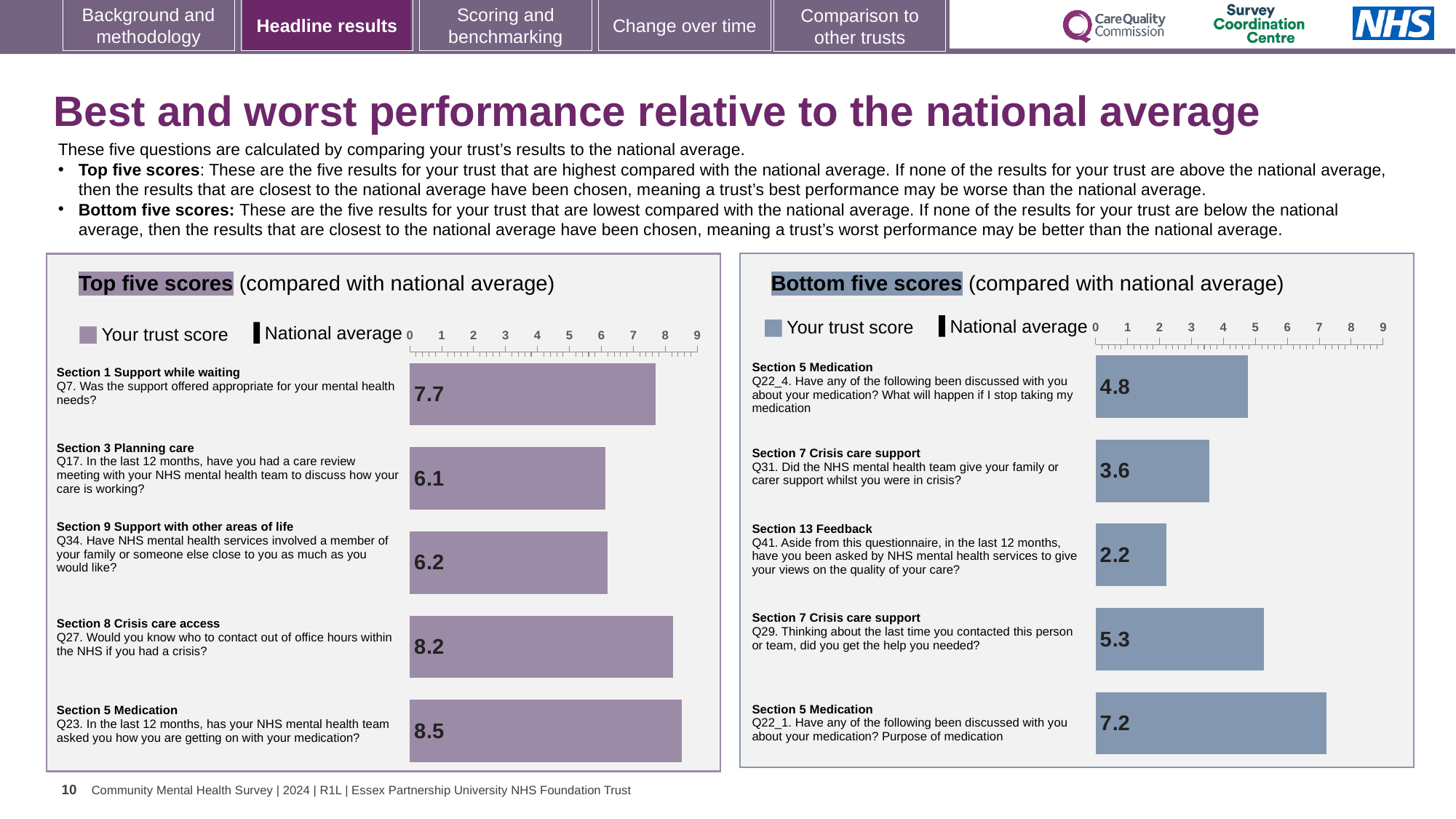
In the Bottom five scores chart, which has the larger trust score, Q22_4 or Q29? Q29 In the Top five scores chart, what is the trust score for Q27 (Would you know who to contact out of office hours within the NHS if you had a crisis?)? 8.2 In the Bottom five scores chart, which question has the highest trust score? Q22_1 In the Top five scores chart, which question has the lowest trust score? Q17 In the Bottom five scores chart, what is the trust score for Q22_1 (Purpose of medication)? 7.2 In the Top five scores chart, what is the trust score for Q17 (care review meeting in the last 12 months)? 6.1 In the Bottom five scores chart, what is the trust score for Q31 (Did the NHS mental health team give your family or carer support whilst you were in crisis?)? 3.6 How many bars are shown in the Bottom five scores chart? 5 In the Bottom five scores chart, which question has the lowest trust score? Q41 What type of chart is the Top five scores chart? Bar chart In the Top five scores chart, what is the difference between the trust scores for Q23 and Q7? 0.8 In the Top five scores chart, which question has the highest trust score? Q23